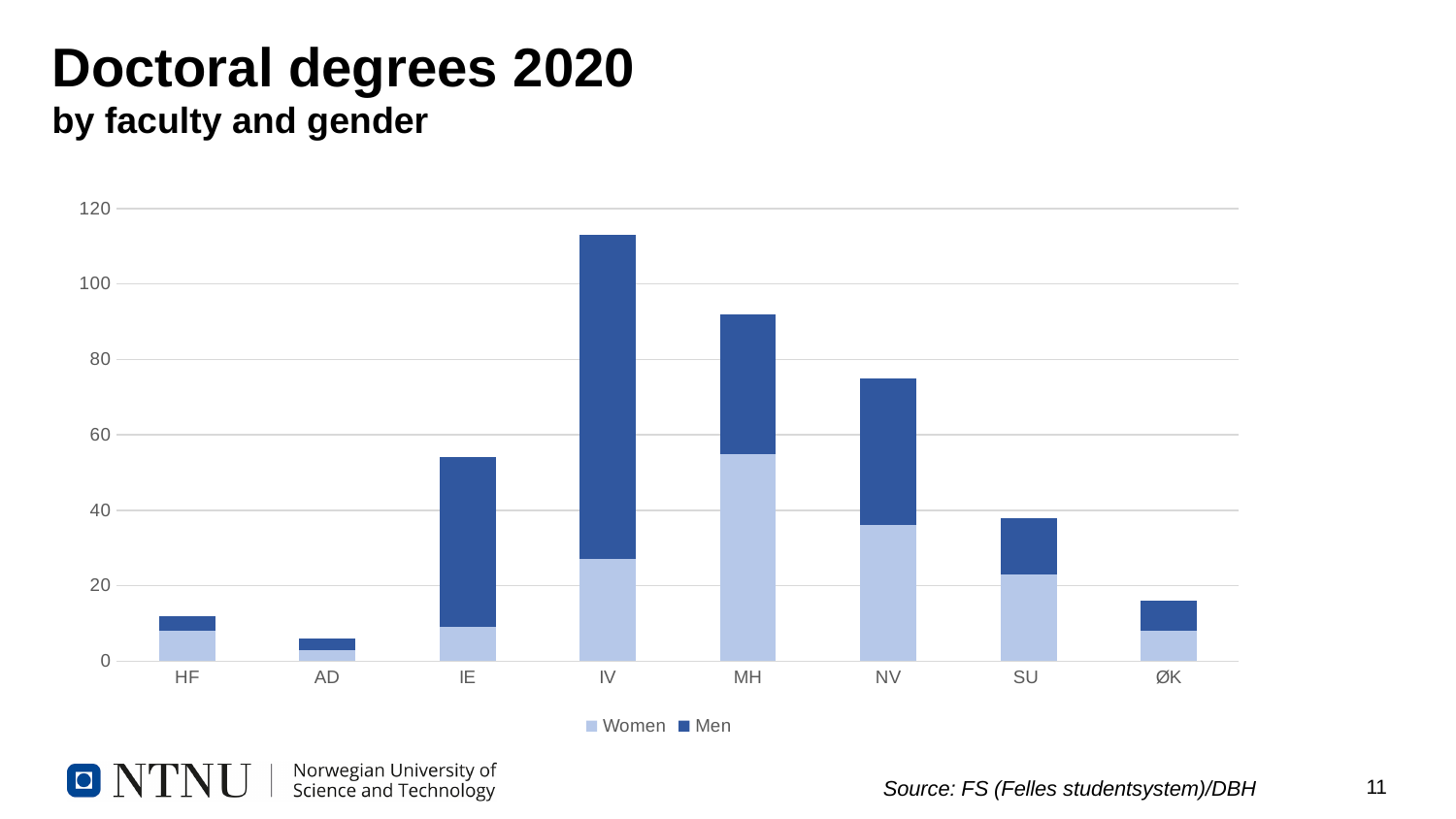
Is the total bar for IV greater or less than 100? greater Is the total bar for HF greater or less than 20? less What are the two series named in the legend? Women and Men Is the Women segment for MH greater or less than 40? greater Which faculty has the tallest stacked bar (most doctoral degrees in total)? IV Which faculty has the larger total bar, MH or NV? MH What kind of chart is shown on the slide? stacked bar chart How many faculties are shown on the x axis? 8 How many series does the legend list? 2 Which faculty has the shortest stacked bar (fewest doctoral degrees in total)? AD Which faculty has the larger total bar, IE or SU? IE